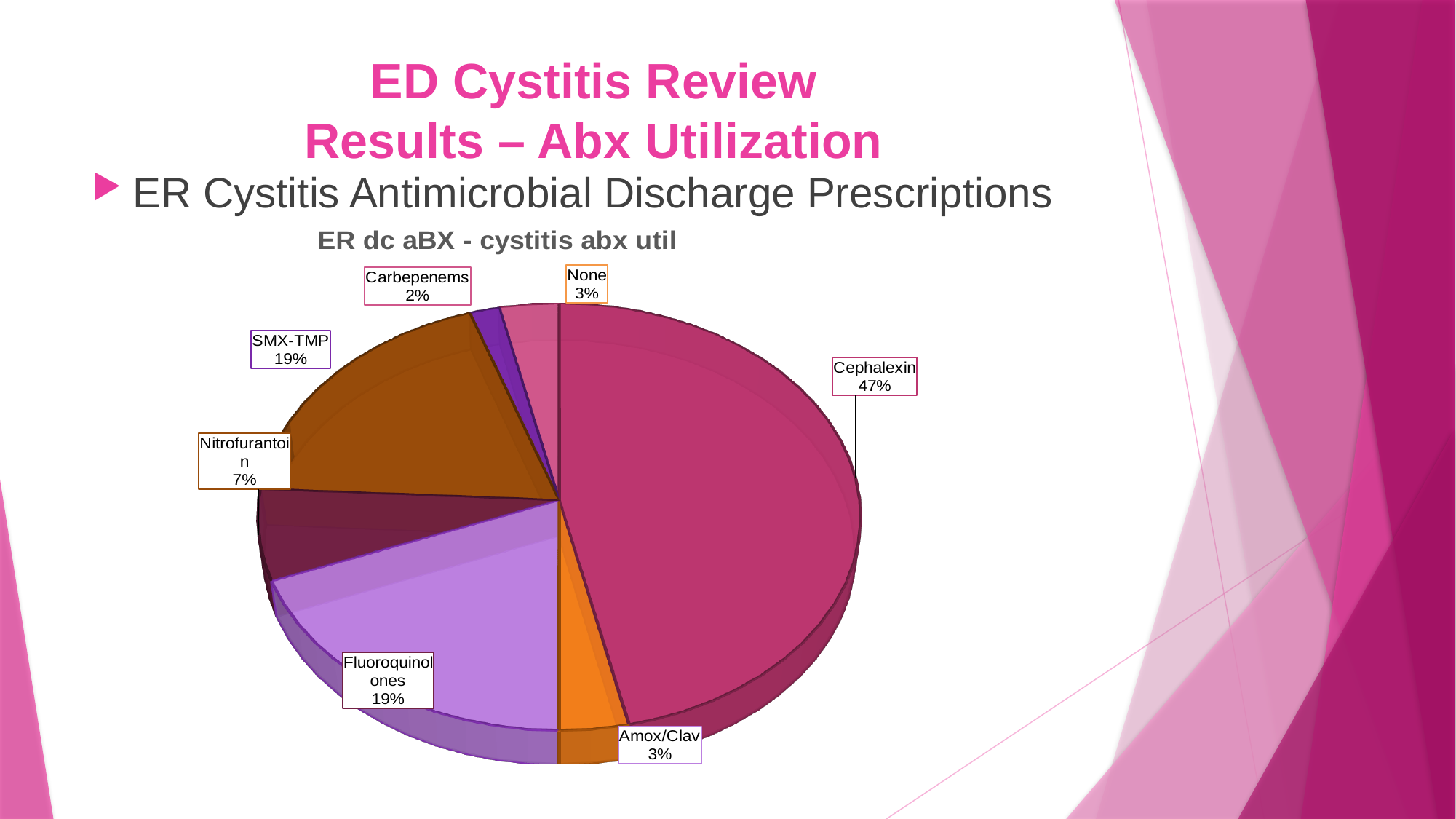
Which is larger, the share for Nitrofurantoin or the share for Amox/Clav? Nitrofurantoin What percentage is shown for Nitrofurantoin? 7% Which category has the largest slice of the pie? Cephalexin What percentage is shown for Carbepenems? 2% What share of the pie does Cephalexin represent? 47% What percentage is shown for None? 3% What is the title of the chart? ER dc aBX - cystitis abx util What kind of chart is shown on the slide? Pie chart Which category has the smallest slice of the pie? Carbepenems How many slices does the pie chart have? 7 What is the difference in percentage points between Cephalexin and SMX-TMP? 28 What percentage is shown for Fluoroquinolones? 19%